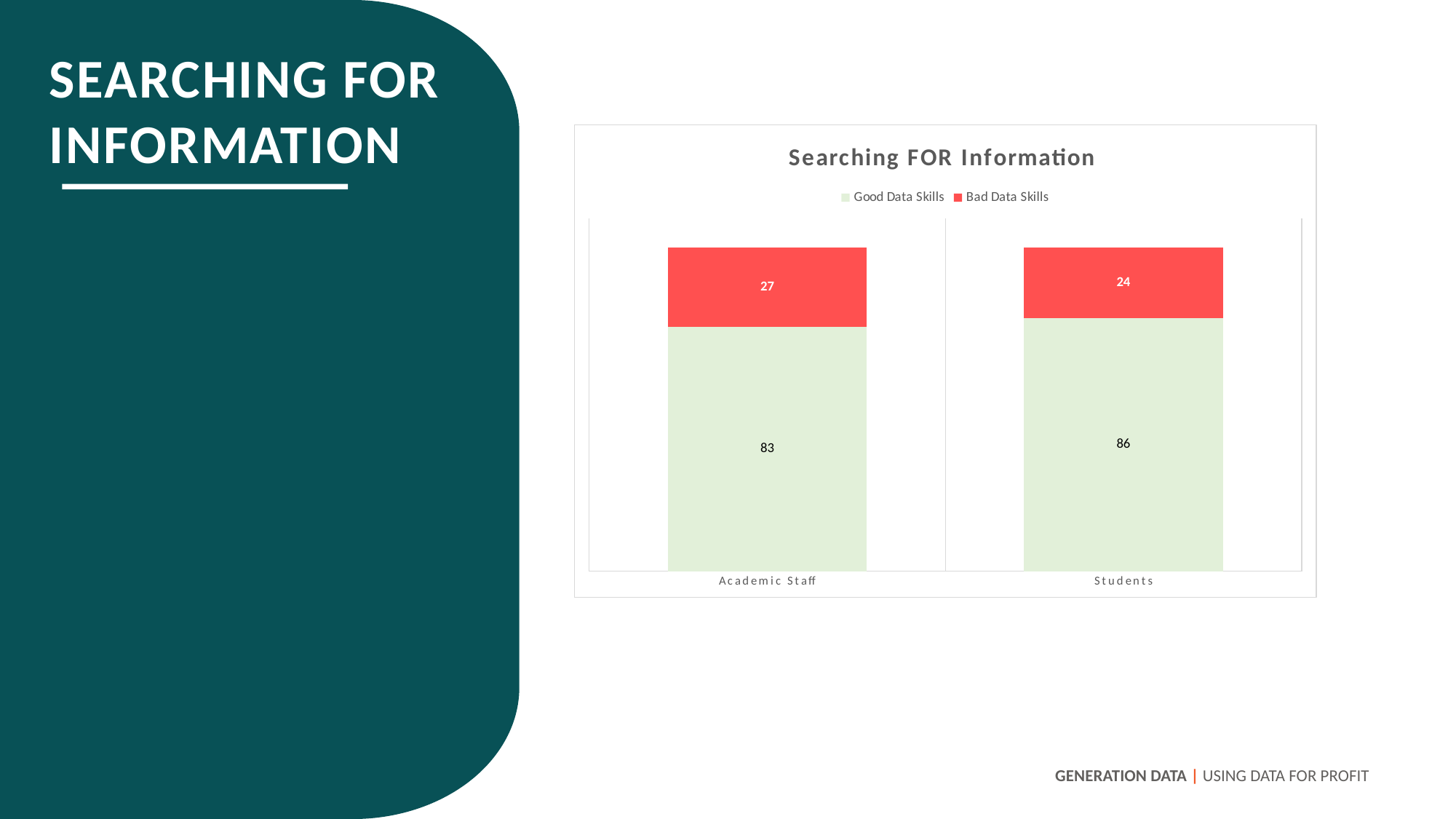
What is the Bad Data Skills value for Students? 24 What is the Good Data Skills value for Academic Staff? 83 Which category has the lower Bad Data Skills value? Students What type of chart is shown? Stacked bar chart What is the Good Data Skills value for Students? 86 What is the total of the stacked bar for Students? 110 How many categories are shown on the x axis? 2 What is the difference between the Good Data Skills values for Students and Academic Staff? 3 What is the total of the stacked bar for Academic Staff? 110 Which category has the higher Good Data Skills value? Students What is the Bad Data Skills value for Academic Staff? 27 How many series does the legend list? 2